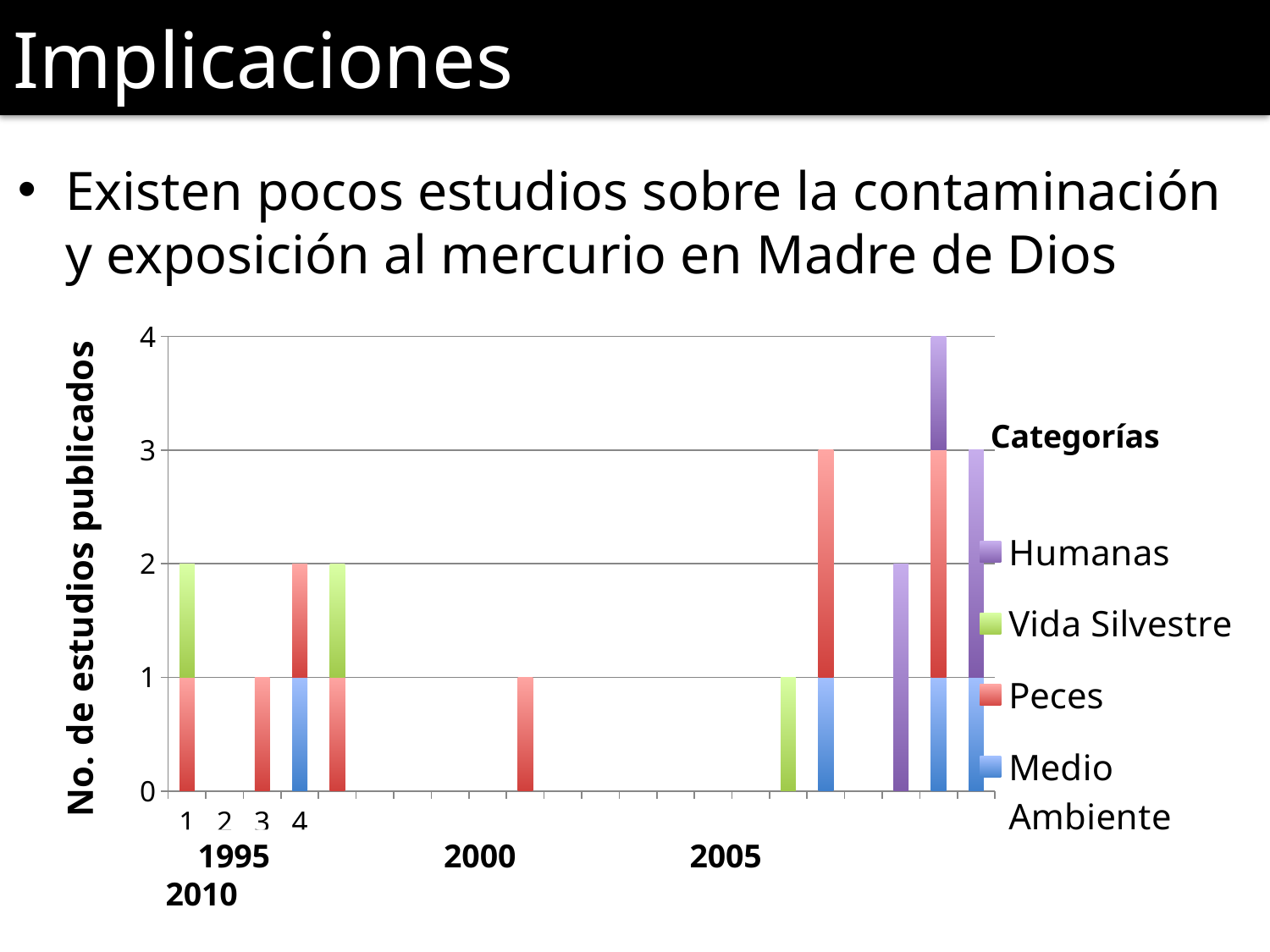
What is the title of the chart's vertical axis? No. de estudios publicados What is the title shown above the chart legend? Categorías What kind of chart is shown on the slide? bar chart What is the total height of the tallest stacked bar in the chart? 4 Which legend series is represented by the green bars? Vida Silvestre Is the total of the tallest stacked bar greater or less than 3? greater What is the highest value shown on the chart's vertical axis? 4 How many series does the chart legend list? 4